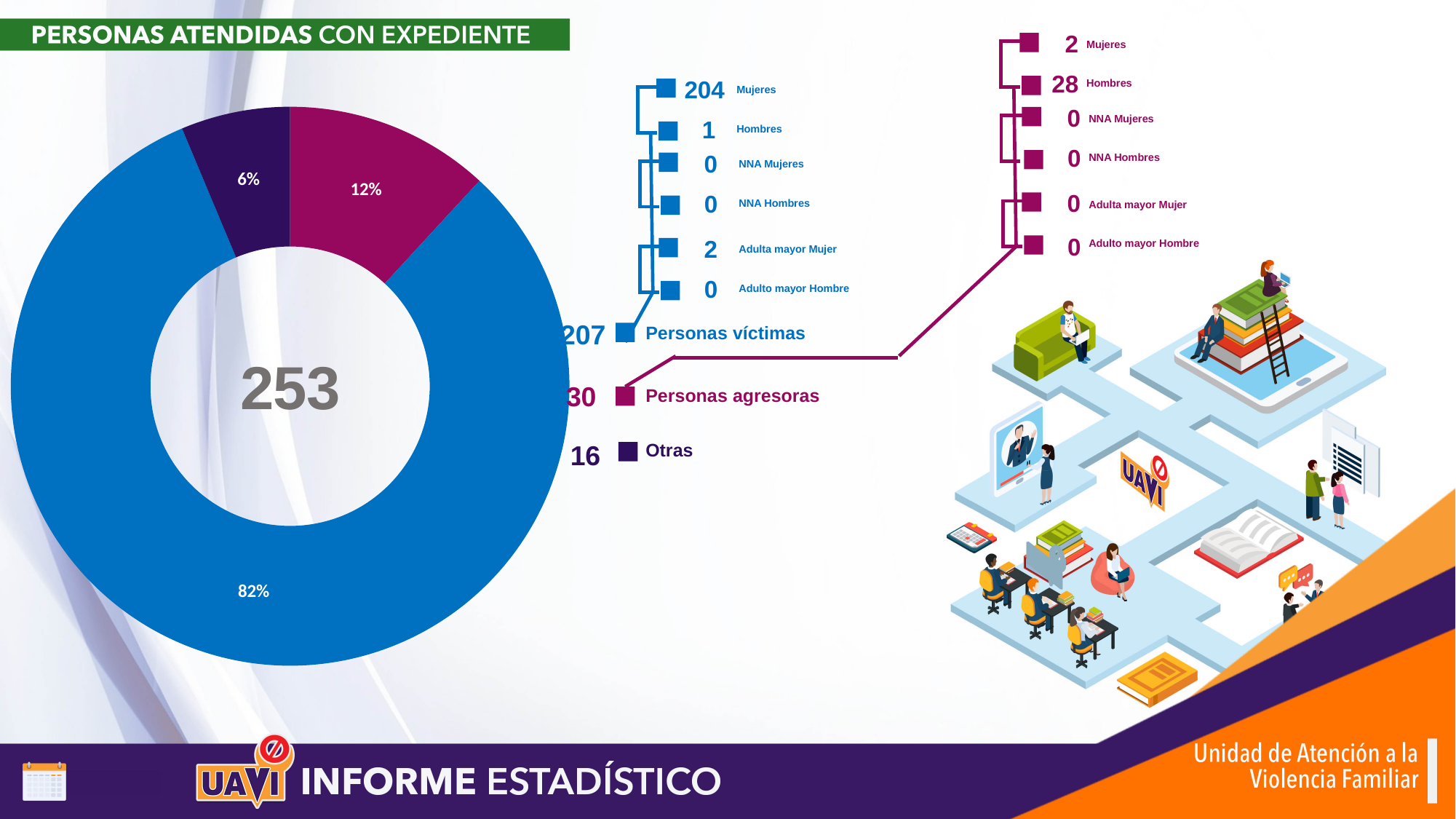
How many categories does the donut chart have? 3 Which category has the largest slice of the donut chart? Personas víctimas What is the difference between the number of Personas víctimas and Personas agresoras? 177 How many Personas víctimas are reported? 207 How many Mujeres are listed under Personas agresoras? 2 What percentage of the donut chart corresponds to Personas agresoras? 12% Which category has the smallest slice of the donut chart? Otras What number is shown in the centre of the donut chart? 253 What kind of chart is shown on the slide? Donut (pie) chart What percentage of the donut chart corresponds to Personas víctimas? 82% How many Personas agresoras are reported? 30 What percentage of the donut chart corresponds to Otras? 6%